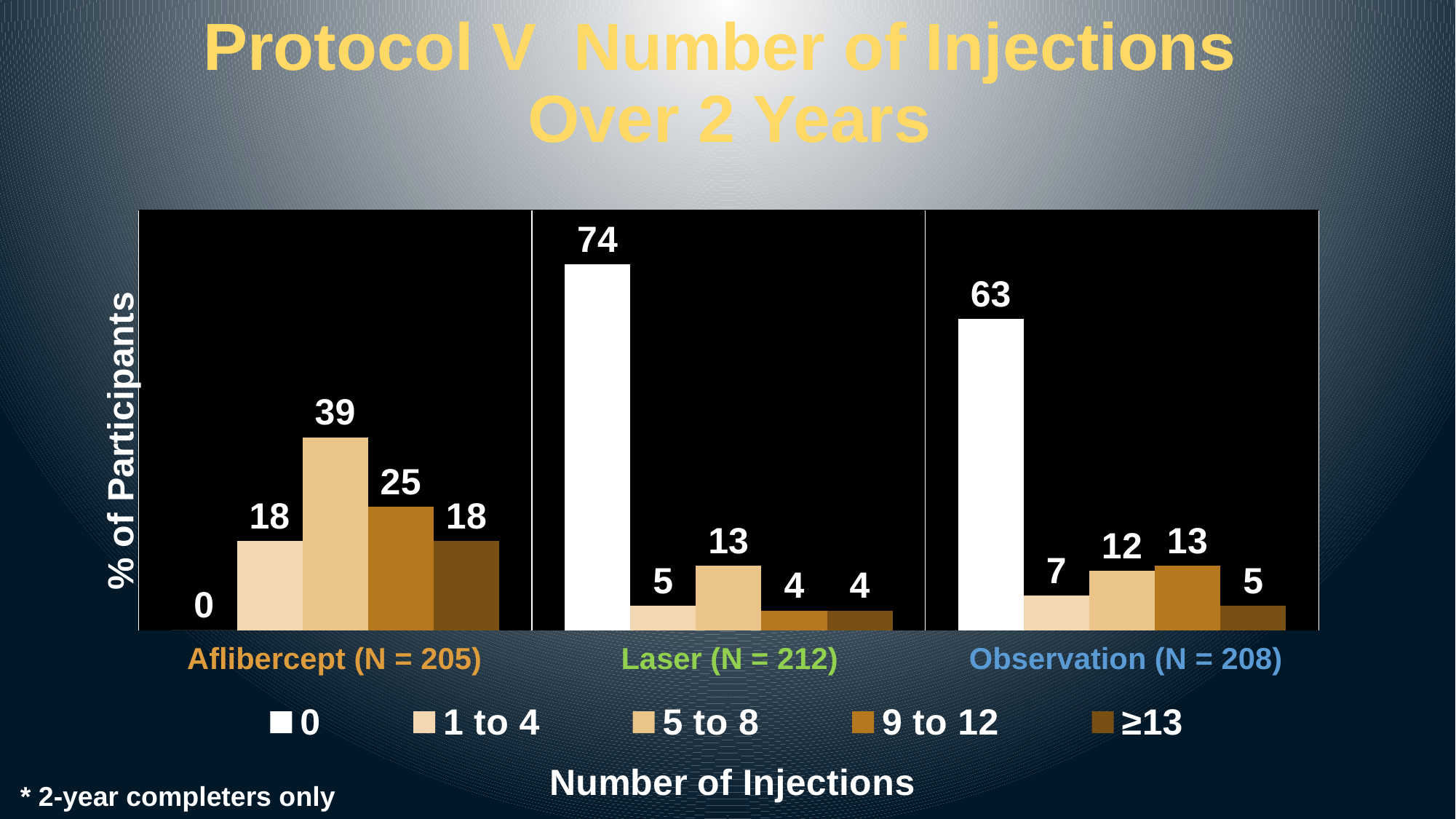
What percentage of Laser participants received 0 injections? 74 Which injection category has the lowest percentage in the Aflibercept group? 0 How many series does the legend list? 5 What percentage of Aflibercept participants received 5 to 8 injections? 39 What percentage of Observation participants received 9 to 12 injections? 13 Which injection category has the highest percentage in the Observation group? 0 What is the label of the y axis? % of Participants What kind of chart is shown on the slide? Bar chart How many treatment groups are shown on the x axis? 3 What is the difference between the percentage of Laser participants with 0 injections and Observation participants with 0 injections? 11 Which is larger: the percentage of Aflibercept participants with 9 to 12 injections or with ≥13 injections? 9 to 12 What percentage of Aflibercept participants received 0 injections? 0